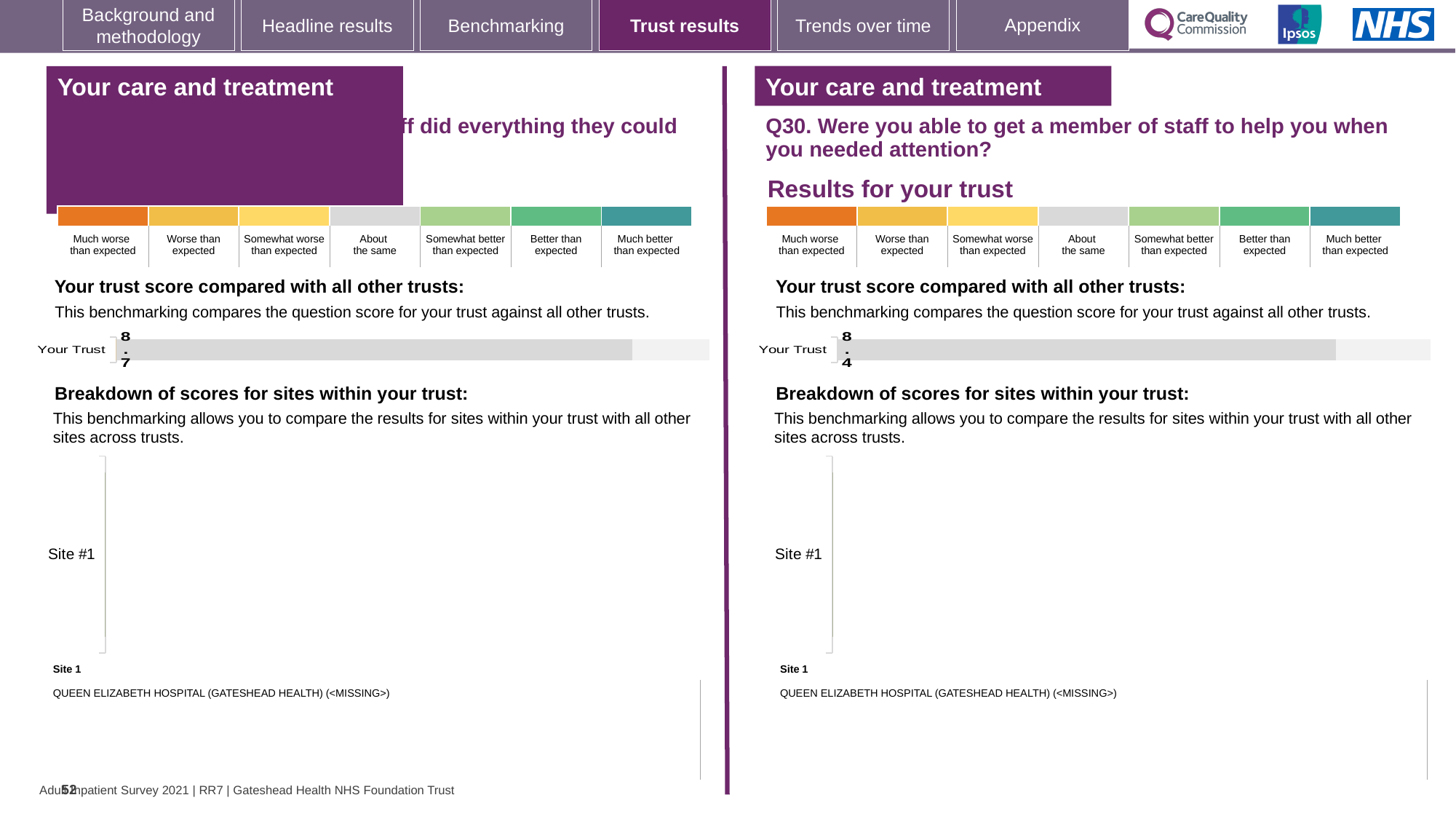
In the right panel (Q30) 'Your trust score compared with all other trusts' chart, what is the score shown for Your Trust? 8.4 Is the Your Trust score in the left panel greater or less than 8.5? greater What is the difference between the Your Trust score in the left panel (8.7) and the Your Trust score in the right panel for Q30 (8.4)? 0.3 Which panel shows the higher Your Trust score: the left panel or the right panel (Q30)? Left panel Which question number is shown in the right panel's title? Q30 How many sites are listed in the right panel's (Q30) 'Breakdown of scores for sites within your trust' chart? 1 Is the Your Trust score in the right panel (Q30) greater or less than 8.5? less In the left panel's 'Your trust score compared with all other trusts' chart, what is the score shown for Your Trust? 8.7 What is the label of the single category in the right panel's (Q30) 'Breakdown of scores for sites within your trust' chart? Site #1 What kind of chart is used to show the Your Trust score in the right panel (Q30)? Bar chart How many categories are plotted in the left panel's 'Your trust score compared with all other trusts' chart? 1